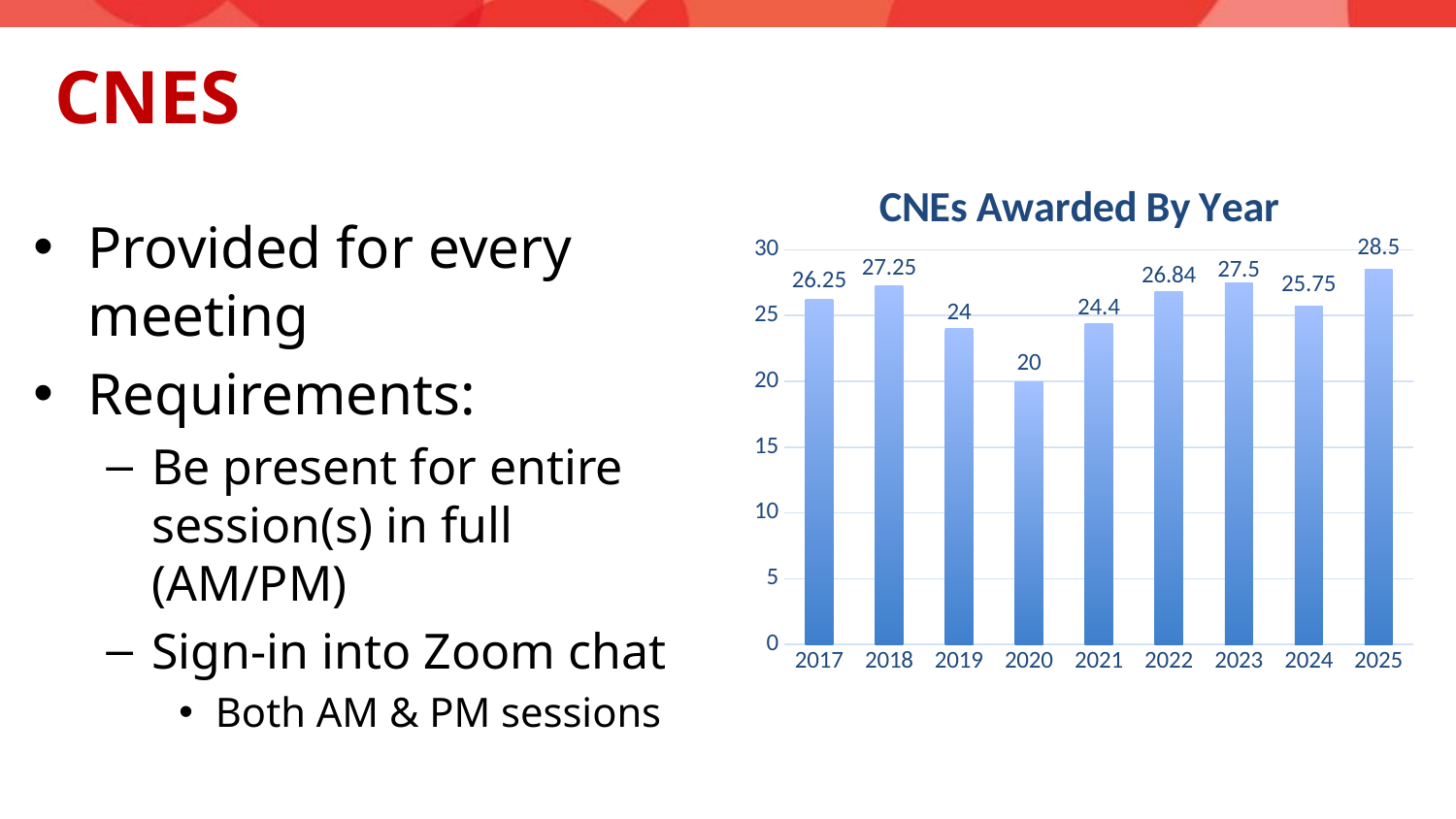
Is the value for 2024 in the CNEs Awarded By Year chart greater or less than 25? greater What is the difference between the values for 2018 and 2017 in the CNEs Awarded By Year chart? 1 What is the value for 2022 in the CNEs Awarded By Year chart? 26.84 What is the value for 2020 in the CNEs Awarded By Year chart? 20 How many years are shown in the CNEs Awarded By Year chart? 9 Which is larger in the CNEs Awarded By Year chart, the value for 2019 or the value for 2021? 2021 What kind of chart is the CNEs Awarded By Year chart? bar chart Which year has the highest value in the CNEs Awarded By Year chart? 2025 What is the value for 2017 in the CNEs Awarded By Year chart? 26.25 Which year has the lowest value in the CNEs Awarded By Year chart? 2020 What is the title of the chart on the slide? CNEs Awarded By Year What is the difference between the values for 2025 and 2020 in the CNEs Awarded By Year chart? 8.5